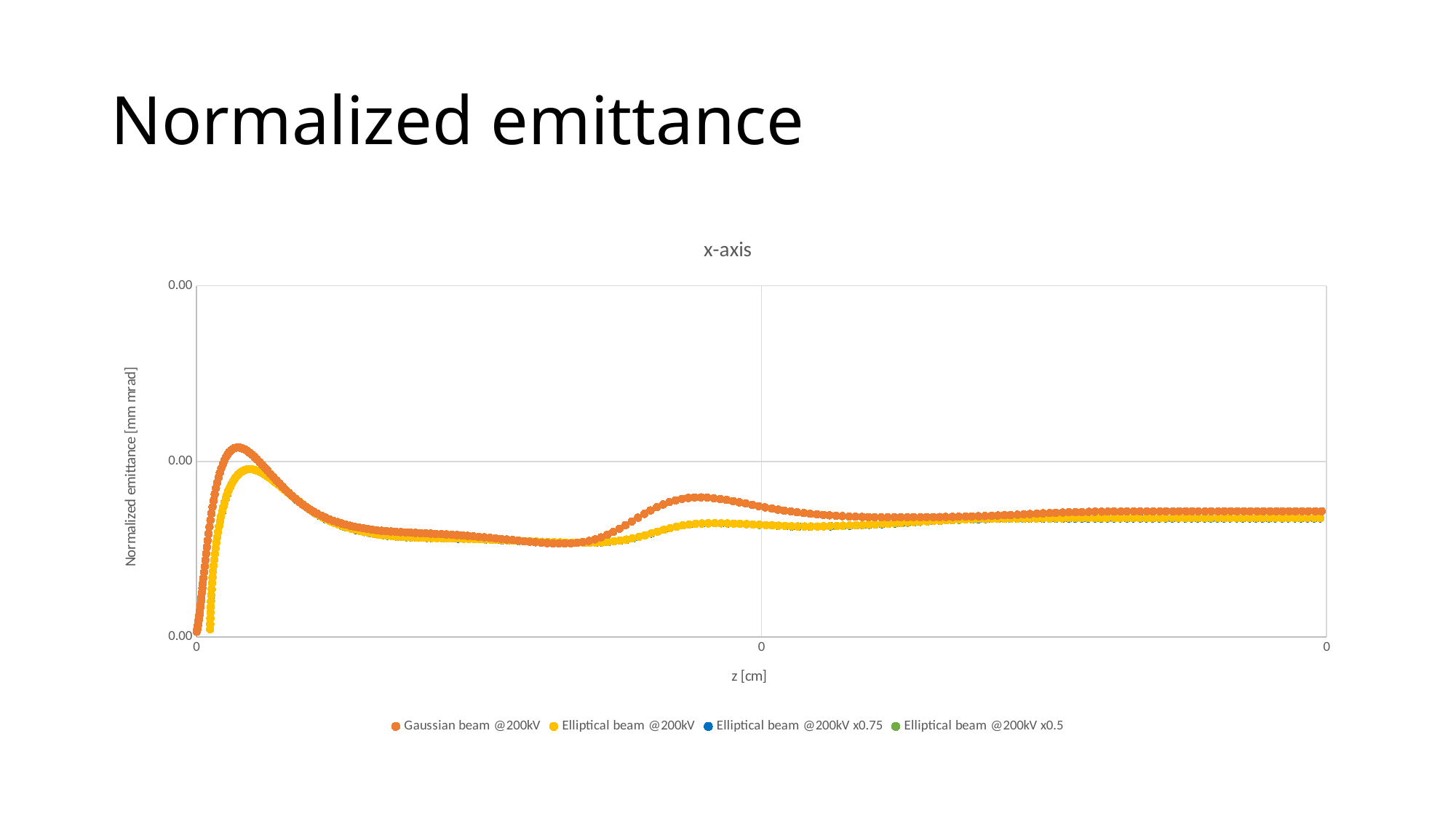
What kind of chart is shown on the slide? Scatter chart Which series reaches the highest value on the chart? Gaussian beam @200kV How many series does the legend list? 4 What is the title of the chart? x-axis At the first peak near the left of the chart, which series is higher: Gaussian beam @200kV or Elliptical beam @200kV? Gaussian beam @200kV Around the middle of the chart, which series shows the larger bump: Gaussian beam @200kV or Elliptical beam @200kV? Gaussian beam @200kV Immediately after its first peak, does the Gaussian beam @200kV series rise or fall along the x axis? Fall What is the label of the vertical axis? Normalized emittance [mm mrad] At the very start of the chart, do the series values rise or fall along the x axis? Rise